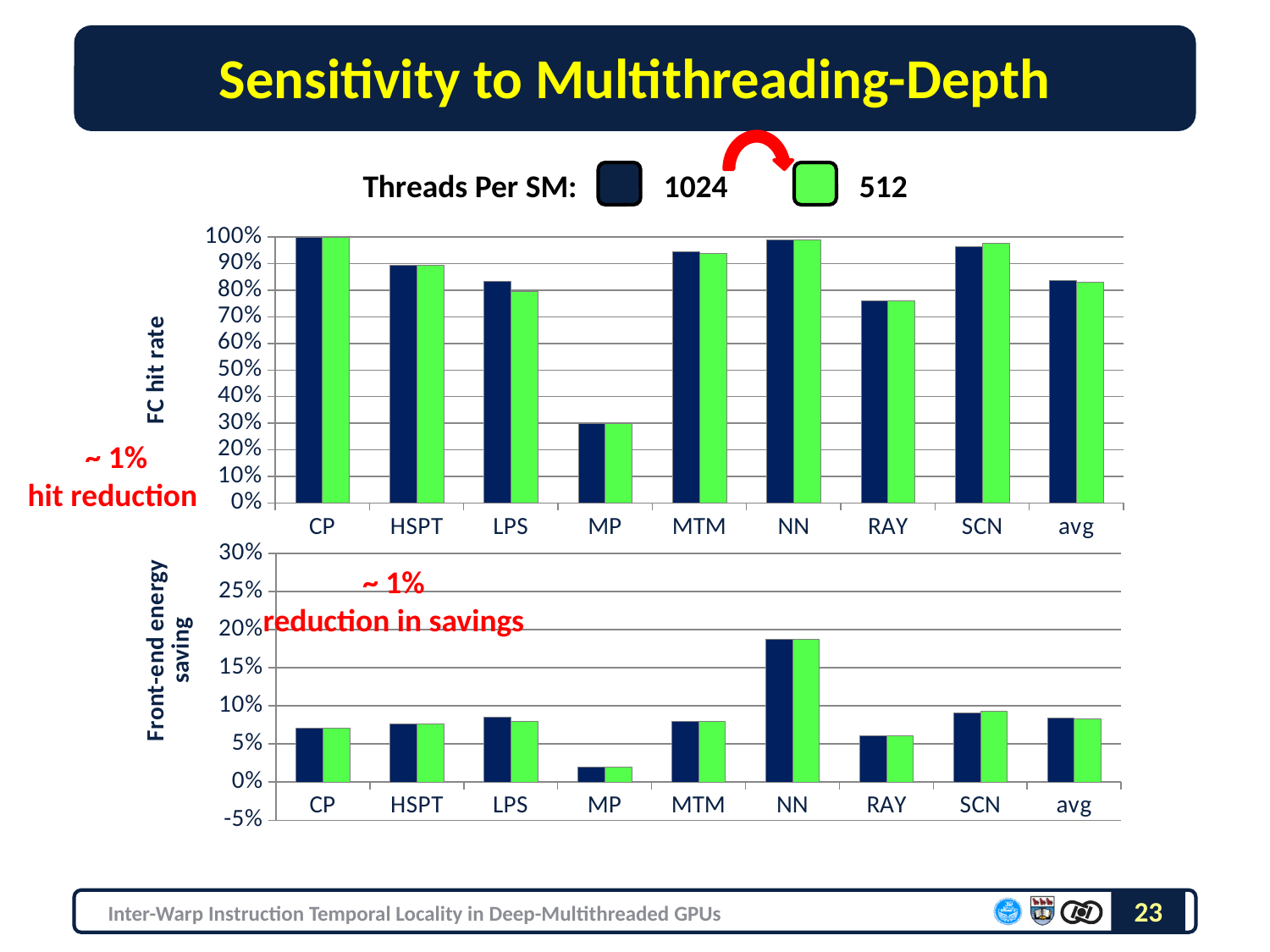
What are the two legend entries for Threads Per SM? 1024 and 512 In the bottom chart (Front-end energy saving), which category has the highest energy saving? NN In the bottom chart (Front-end energy saving), which category has the lowest energy saving? MP How many categories are shown on the x axis of the bottom chart (Front-end energy saving)? 9 In the bottom chart (Front-end energy saving), is the value for NN at 512 threads greater or less than 15%? greater In the top chart (FC hit rate), which category has the lowest hit rate? MP In the top chart (FC hit rate), is the value for MTM at 1024 threads greater or less than 90%? greater In the bottom chart (Front-end energy saving), which is larger at 1024 threads: NN or SCN? NN In the top chart (FC hit rate), is the value for MP at 1024 threads greater or less than 40%? less In the top chart (FC hit rate), which category has the highest hit rate? CP What kind of chart is the top chart (FC hit rate)? bar chart How many series does the legend (Threads Per SM) list? 2